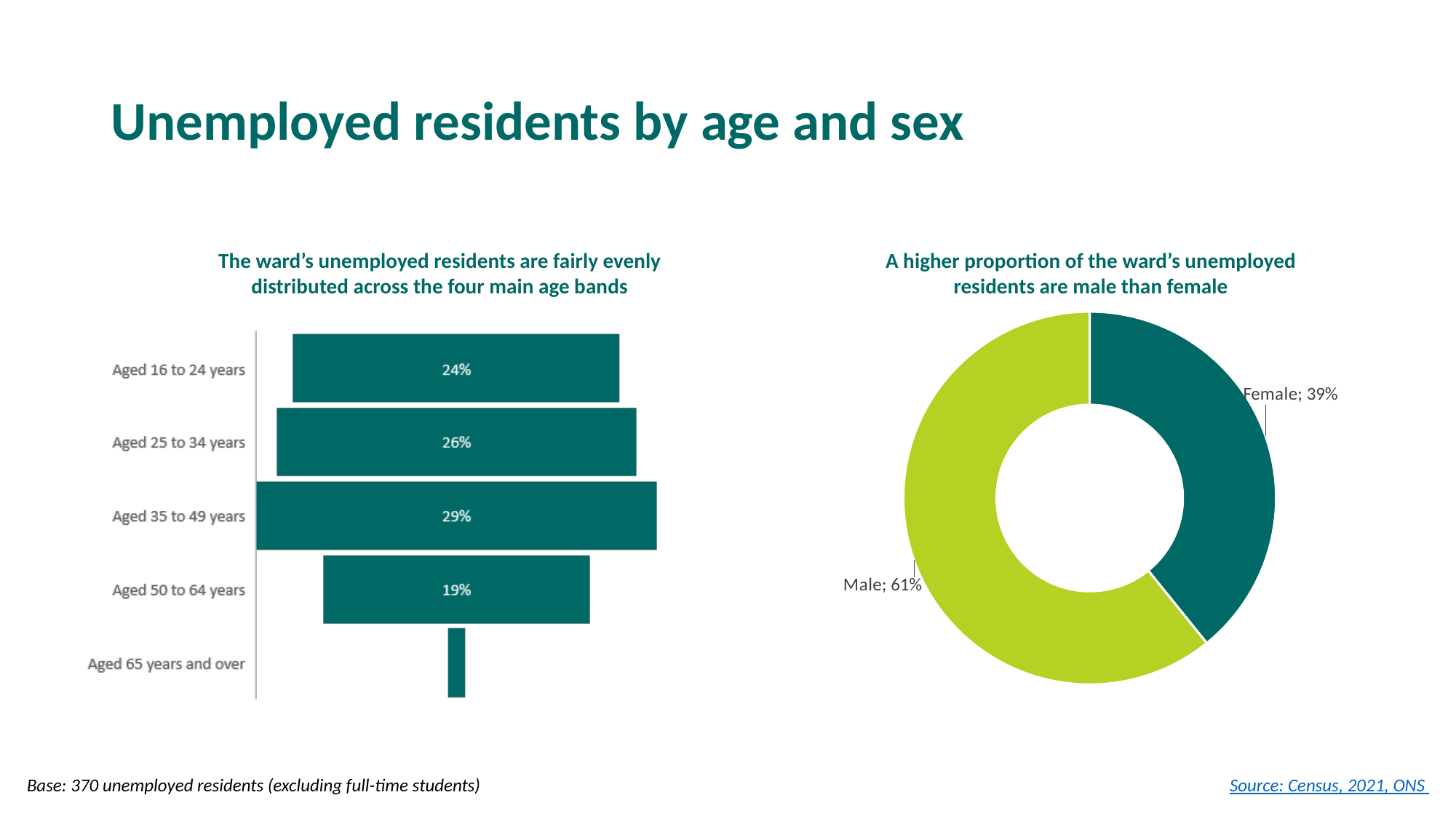
In the age bar chart on the left, what is the value for Aged 16 to 24 years? 24% In the age bar chart on the left, which age band has the highest value? Aged 35 to 49 years What is the title of the chart on the right of the slide? A higher proportion of the ward's unemployed residents are male than female In the age bar chart on the left, what is the value for Aged 35 to 49 years? 29% In the age bar chart on the left, which age band has the lowest value? Aged 65 years and over In the age bar chart on the left, which is larger: Aged 25 to 34 years or Aged 16 to 24 years? Aged 25 to 34 years In the sex chart on the right, what share of unemployed residents are male? 61% In the age bar chart on the left, what is the value for Aged 50 to 64 years? 19% What kind of chart is the chart on the left of the slide? Bar chart In the age bar chart on the left, what is the difference between Aged 35 to 49 years and Aged 50 to 64 years? 10% In the sex chart on the right, what is the value for Female? 39% How many age bands are shown in the bar chart on the left? 5